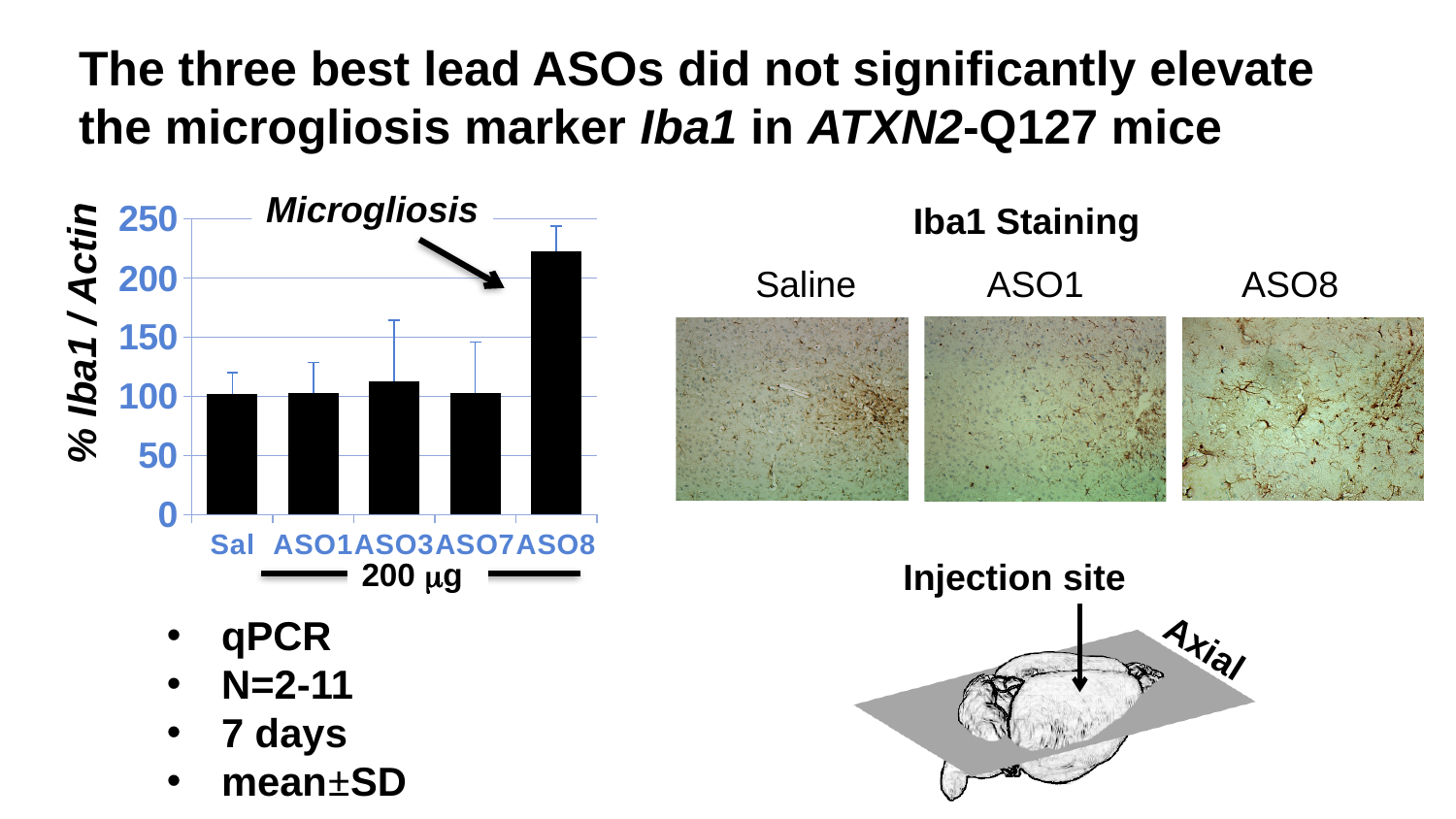
What is the label on the y axis of the bar chart? % Iba1 / Actin Which is larger, the value for ASO8 or the value for ASO3? ASO8 Which bar does the 'Microgliosis' arrow annotation point to? ASO8 Is the value for ASO8 greater or less than 200? greater Which category has the highest value in the bar chart? ASO8 Is the value for ASO1 greater or less than 150? less Which is larger, the value for ASO8 or the value for Sal? ASO8 Is the value for ASO3 greater or less than 150? less How many categories are shown on the x axis of the bar chart? 5 What kind of chart is shown on the left of the slide? bar chart